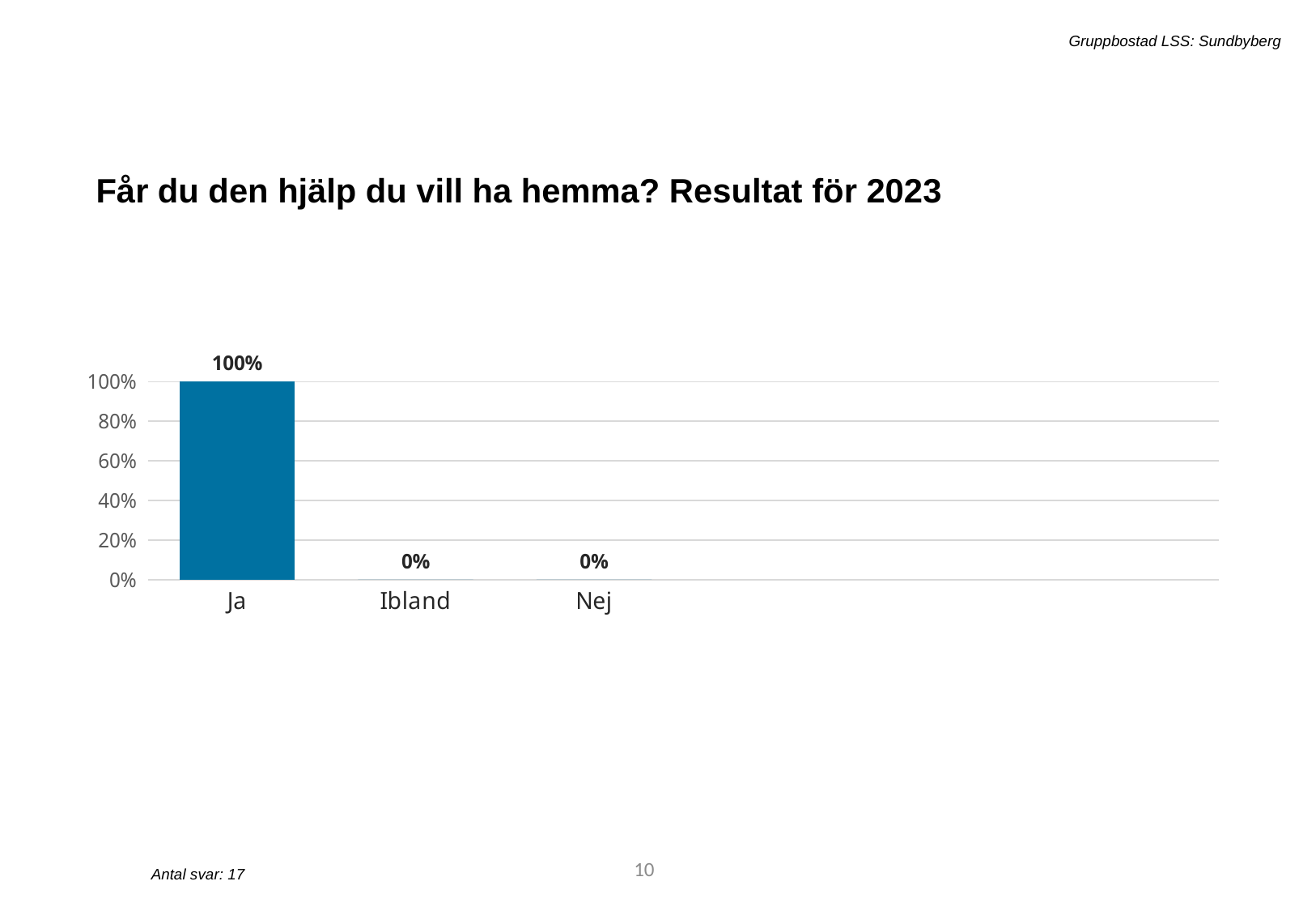
What is the value for Ibland? 0% Is the value for Ja greater or less than 80%? greater How many categories are shown on the x axis? 3 Which category has the highest value? Ja What is the value for Nej? 0% What is the title of the chart? Får du den hjälp du vill ha hemma? Resultat för 2023 Do the values rise or fall from Ja to Nej along the x axis? fall Which is larger, the value for Ja or the value for Ibland? Ja What kind of chart is shown on the slide? bar chart What is the highest value shown on the y axis? 100% What is the difference between the values for Ja and Nej? 100% What is the value for Ja? 100%